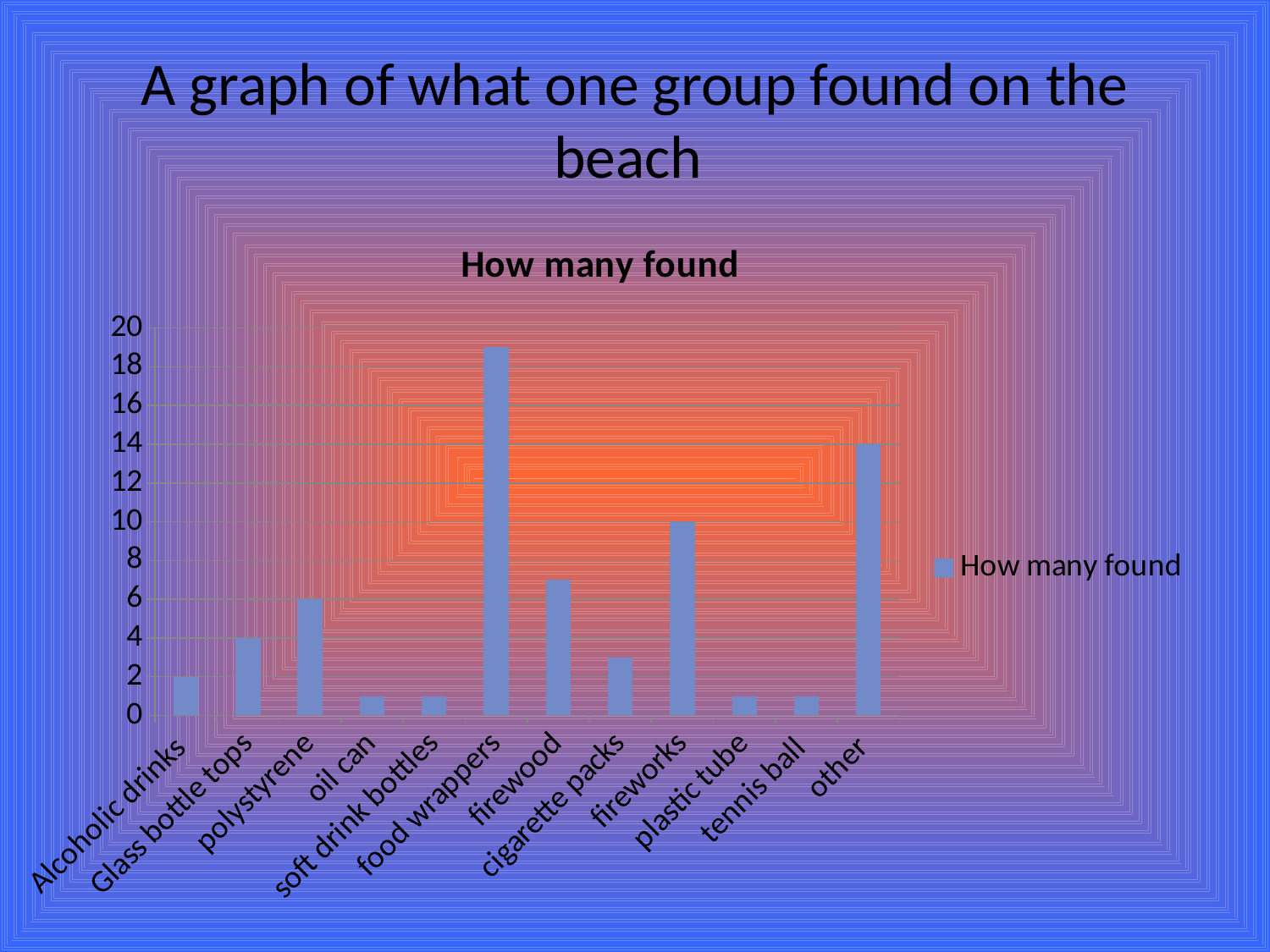
How many categories are shown on the x axis of the chart? 12 Which category has the highest value? food wrappers What type of chart is shown on the slide? bar chart Is the value for food wrappers greater or less than 18? greater What is the title of the chart? How many found How many series does the legend list? 1 What is the value for other? 14 What is the value for Glass bottle tops? 4 What is the difference between the value for other and the value for fireworks? 4 What is the value for fireworks? 10 What is the value for polystyrene? 6 Which is larger, the value for fireworks or the value for other? other